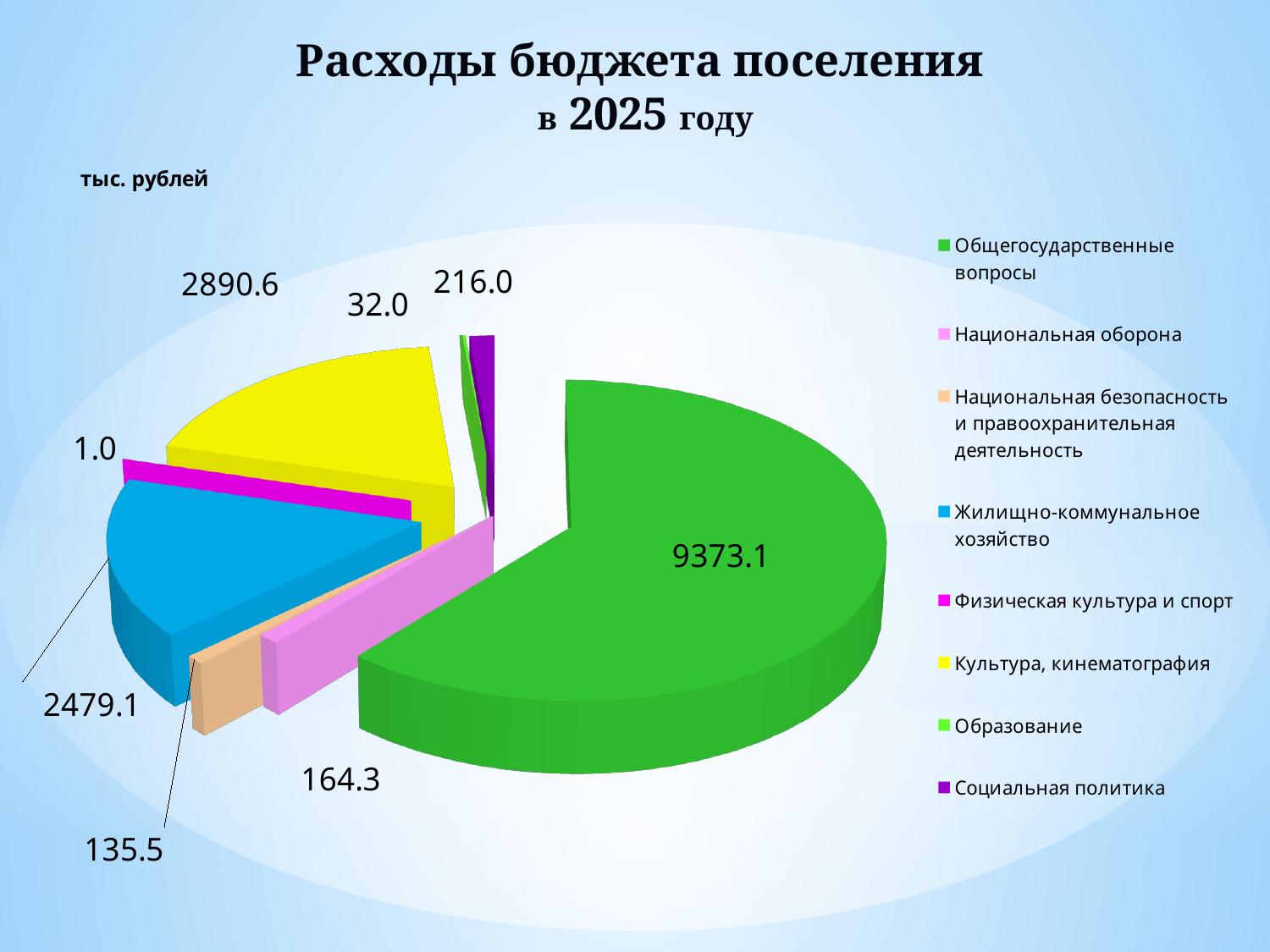
What is the difference between the values for Культура, кинематография and Жилищно-коммунальное хозяйство? 411.5 What is the value for Социальная политика? 216.0 Which is larger: the value for Социальная политика or the value for Национальная оборона? Социальная политика What type of chart is shown on the slide? pie chart Which category has the largest share of the pie? Общегосударственные вопросы What unit is stated for the values on the chart? тыс. рублей Which category has the smallest value? Физическая культура и спорт How many categories does the legend list? 8 What is the value for Жилищно-коммунальное хозяйство? 2479.1 What is the value for Культура, кинематография? 2890.6 What is the value for Общегосударственные вопросы? 9373.1 What is the value for Национальная безопасность и правоохранительная деятельность? 135.5